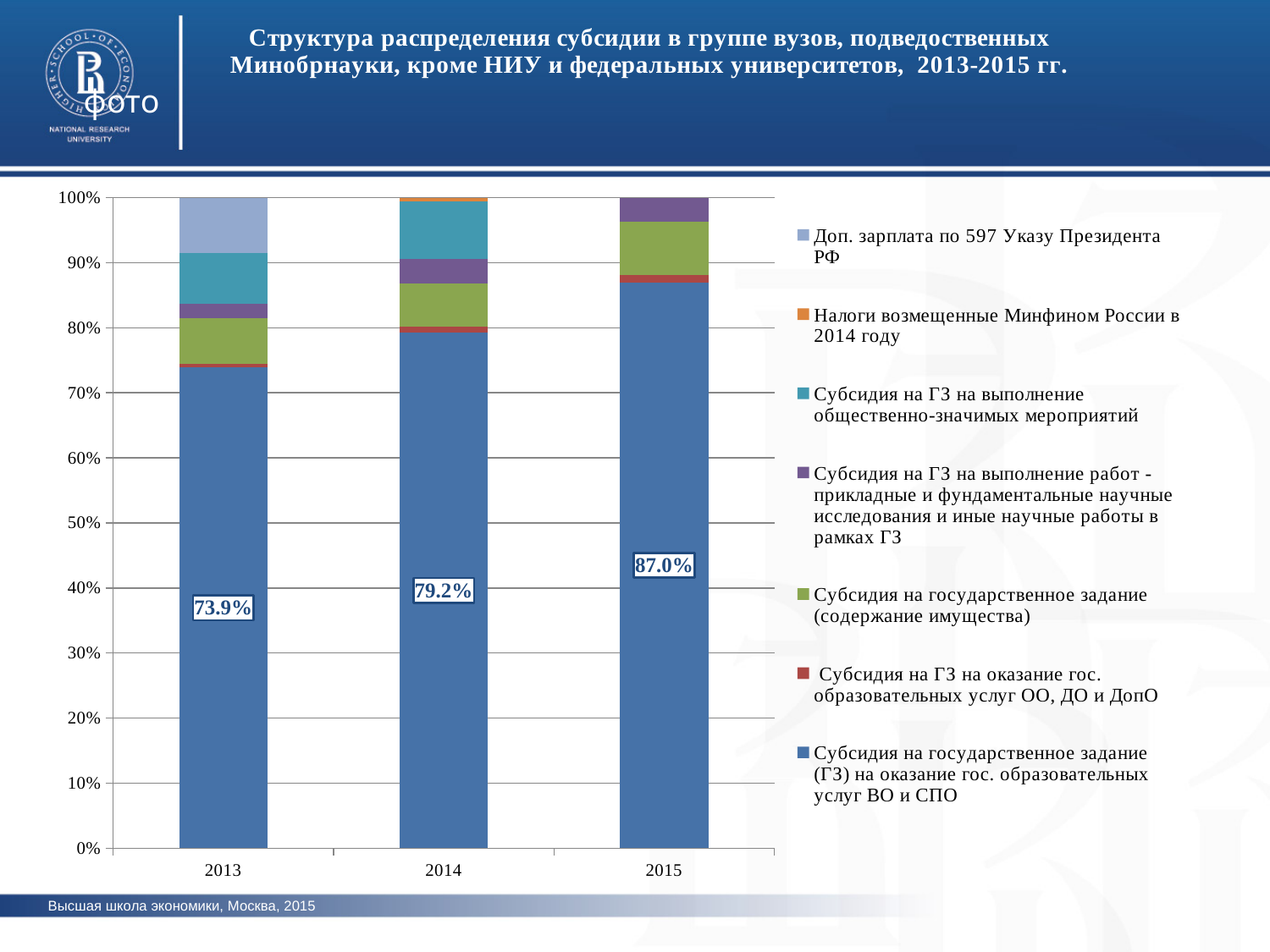
What is the labelled share of the series 'Субсидия на государственное задание (ГЗ) на оказание гос. образовательных услуг ВО и СПО' in 2015? 87.0% What kind of chart is shown on the slide? Stacked bar chart In which year is the labelled share of the blue series (ГЗ на оказание гос. образовательных услуг ВО и СПО) the highest? 2015 Is the labelled share of the blue series in 2015 greater or less than 90%? less By how many percentage points does the labelled share of the blue series in 2015 exceed that in 2013? 13.1 percentage points How many years are shown on the x axis of the chart? 3 How many series does the legend of the chart list? 7 Which year has the larger labelled share for the blue series: 2014 or 2015? 2015 Does the labelled share of the blue series rise or fall from 2013 to 2015? Rises In which year is the labelled share of the blue series (ГЗ на оказание гос. образовательных услуг ВО и СПО) the lowest? 2013 What is the labelled share of the series 'Субсидия на государственное задание (ГЗ) на оказание гос. образовательных услуг ВО и СПО' in 2013? 73.9% What is the labelled share of the series 'Субсидия на государственное задание (ГЗ) на оказание гос. образовательных услуг ВО и СПО' in 2014? 79.2%